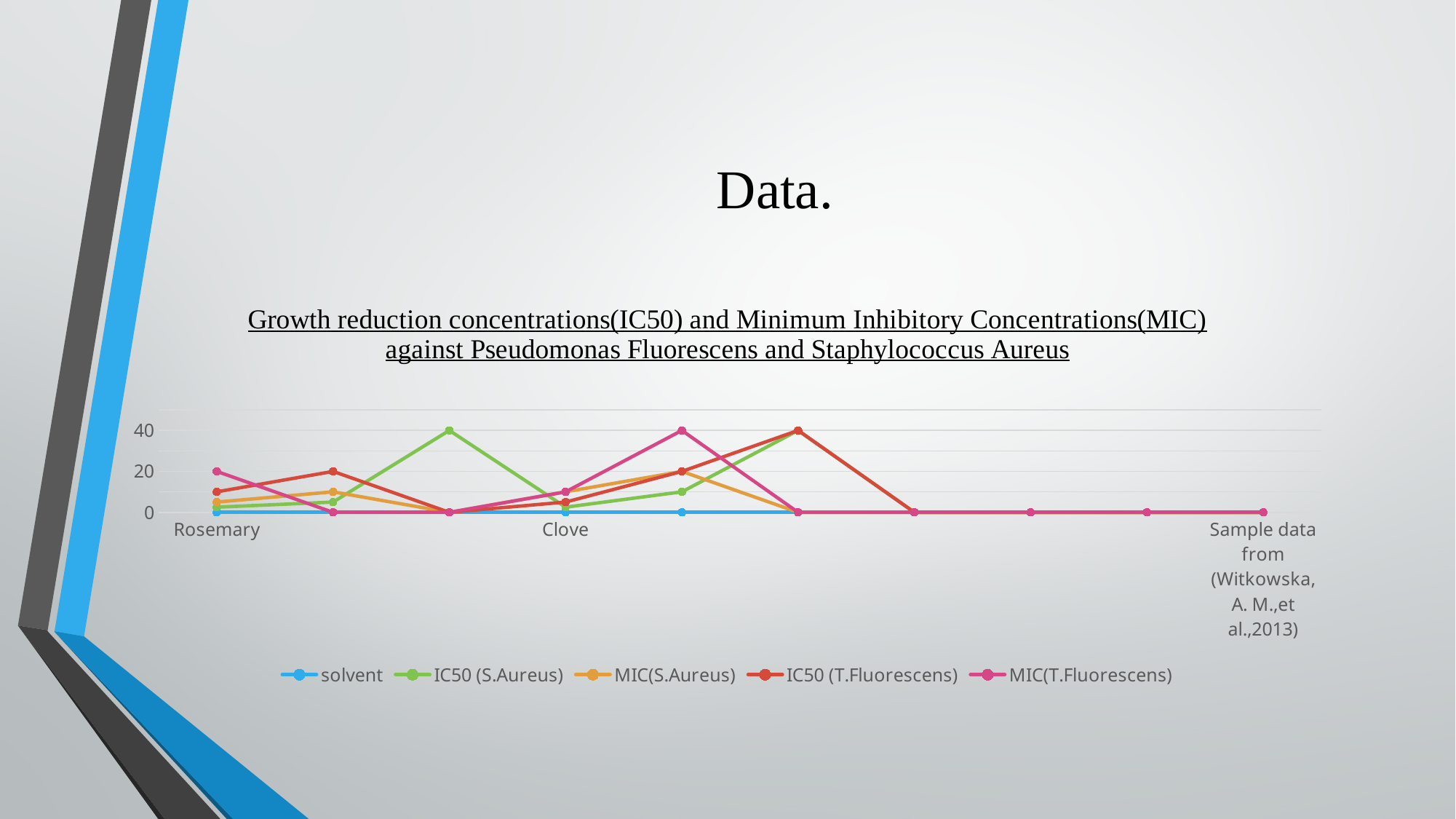
Does the solvent series rise, fall, or stay flat along the x axis? stays flat Is the value of MIC(T.Fluorescens) at Clove greater or less than 20? less How many series does the legend list? 5 Which series has the highest value at Rosemary? MIC(T.Fluorescens) What is the value of the solvent series at Clove? 0 What is the value of the solvent series at Rosemary? 0 What colour is the line for the solvent series? light blue Is the value of IC50 (S.Aureus) at Rosemary greater or less than 20? less What kind of chart is shown on the slide? line chart At Rosemary, which is larger: MIC(T.Fluorescens) or IC50 (T.Fluorescens)? MIC(T.Fluorescens)